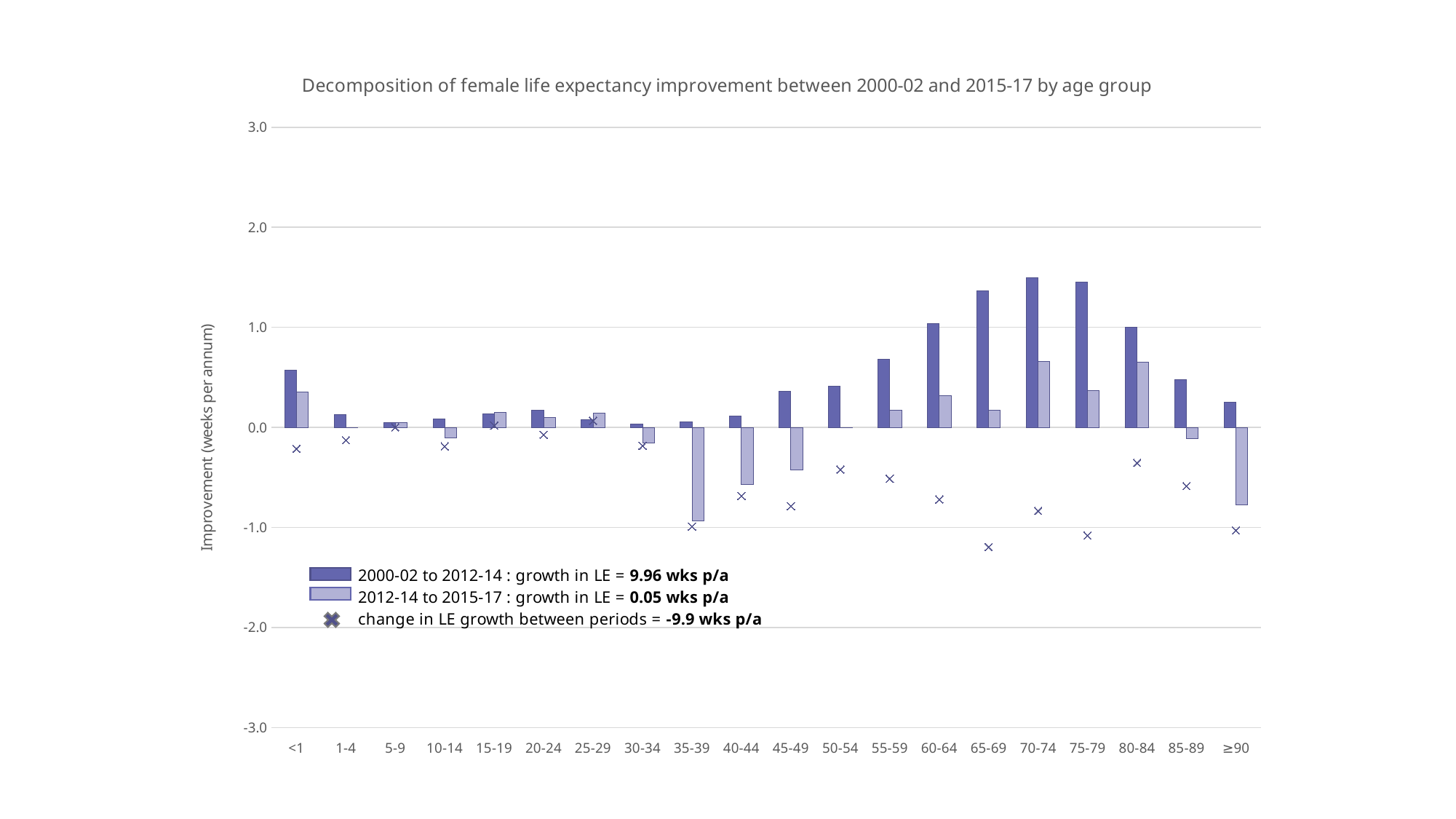
Which is larger in the 2000-02 to 2012-14 series: the value for 60-64 or the value for 55-59? 60-64 Is the value for the 55-59 age group in the 2000-02 to 2012-14 series greater or less than 1.0? less Is the value for the 65-69 age group in the 2000-02 to 2012-14 series greater or less than 1.0? greater Which is larger for the 80-84 age group: the 2000-02 to 2012-14 bar or the 2012-14 to 2015-17 bar? 2000-02 to 2012-14 According to the legend, what is the growth in LE for the 2000-02 to 2012-14 period? 9.96 wks p/a How many age-group categories are shown on the x axis? 20 Which age group has the lowest value for the 'change in LE growth between periods' series? 65-69 How many series does the legend list? 3 Is the value for the 40-44 age group in the 2012-14 to 2015-17 series greater or less than 0.0? less Which age group has the lowest value for the 2012-14 to 2015-17 series? 35-39 What type of chart is shown on the slide? combination chart: bars with x markers (bar and line chart) According to the legend, what is the change in LE growth between periods? -9.9 wks p/a